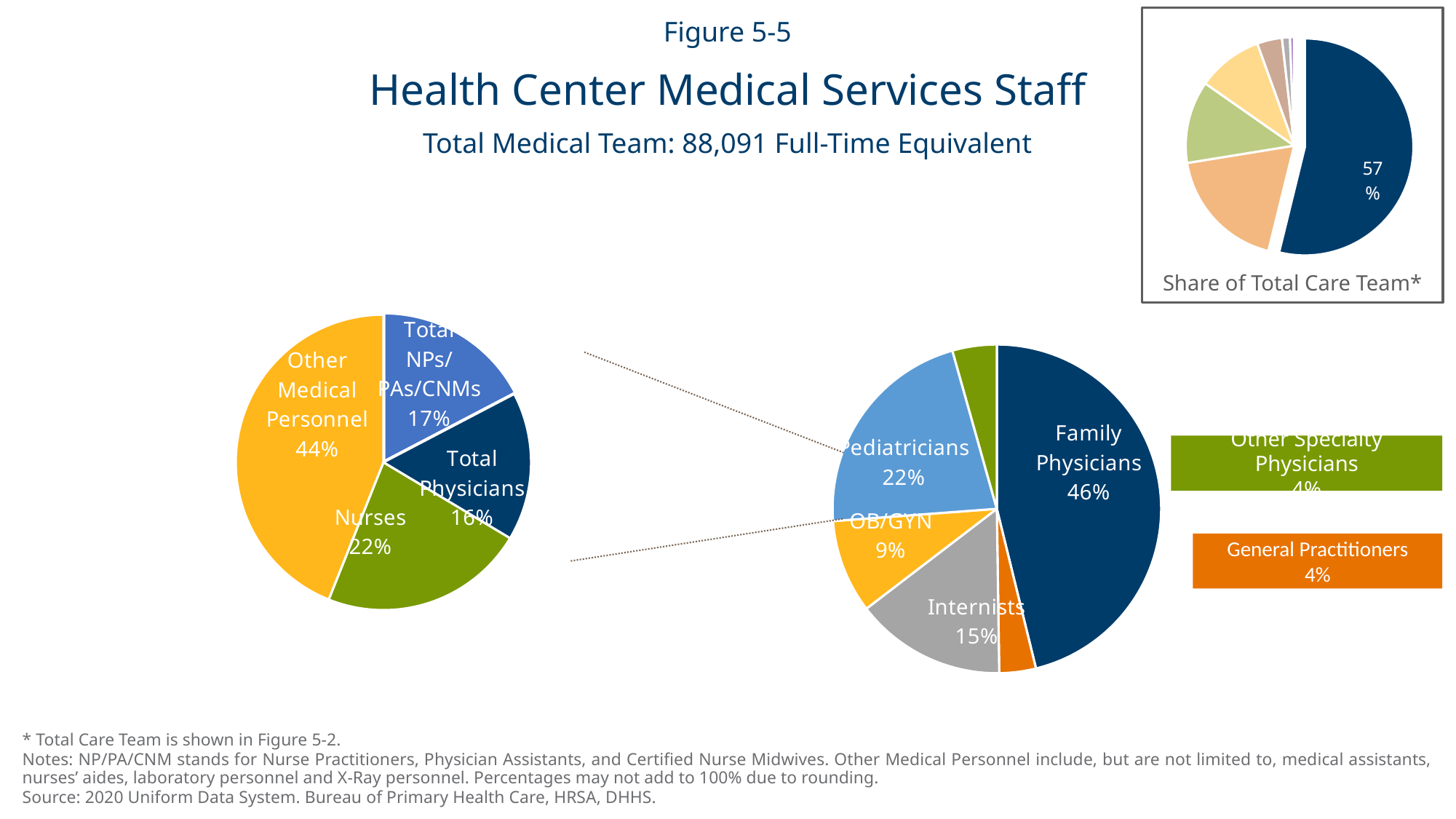
In the right pie chart, what is the difference between the Family Physicians share and the Pediatricians share? 24% In the left pie chart, what share is Other Medical Personnel? 44% In the left pie chart, which category has the largest share? Other Medical Personnel In the right pie chart, which physician category has the largest share? Family Physicians In the small 'Share of Total Care Team' pie chart in the top right, what percentage is labeled on the dark blue slice? 57% In the right pie chart, what share is OB/GYN? 9% How many slices does the left pie chart have? 4 In the left pie chart, which is larger: Nurses or Total NPs/PAs/CNMs? Nurses In the left pie chart, which category has the smallest share? Total Physicians In the right pie chart, what share is Internists? 15% How many slices does the right pie chart (physicians breakdown) have? 6 What type of chart is used on this slide? Pie chart